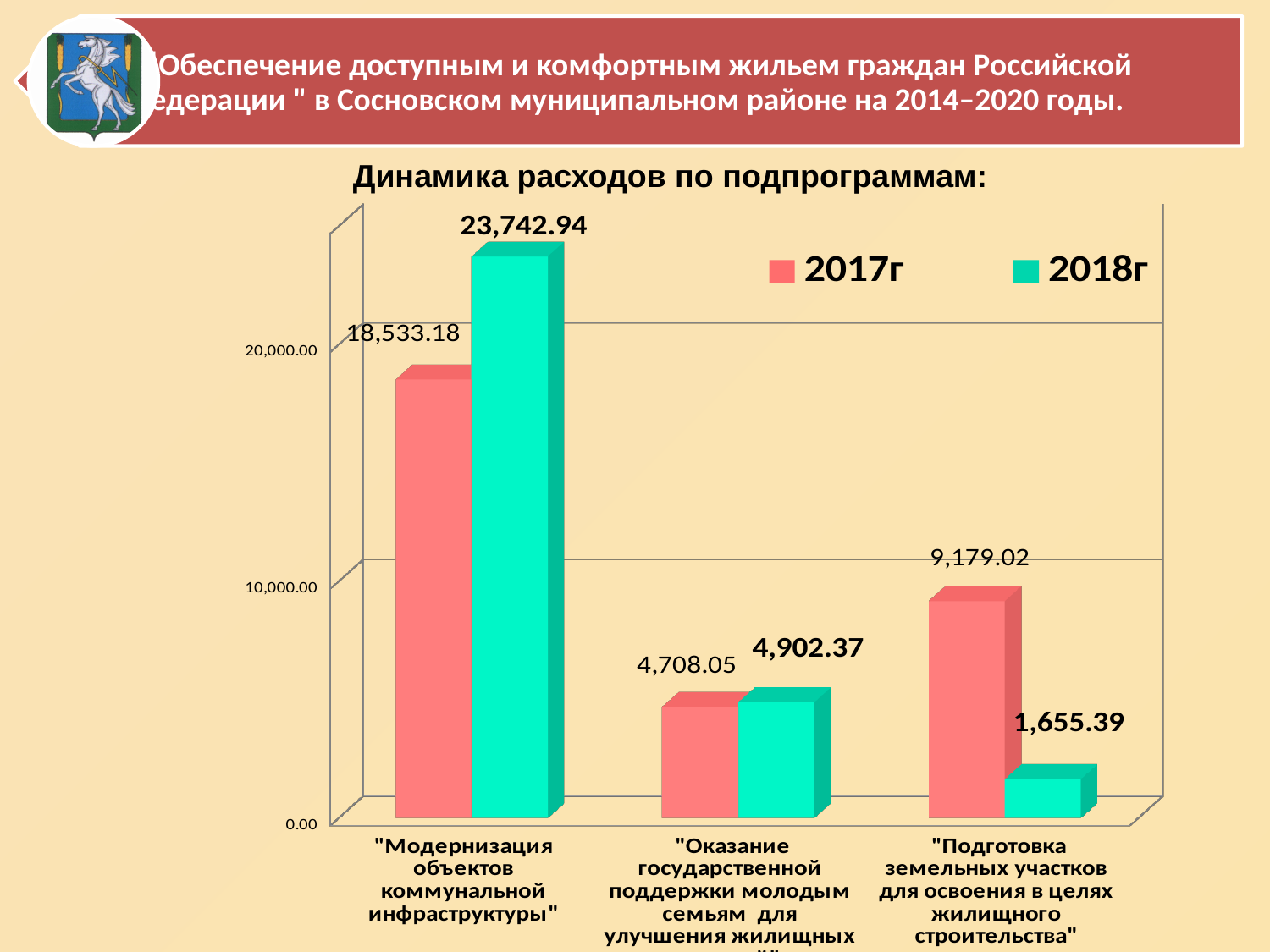
What is the difference between the 2018г and 2017г values for "Модернизация объектов коммунальной инфраструктуры"? 5,209.76 How many categories are shown on the x axis? 3 Which category has the lowest 2017г value? "Оказание государственной поддержки молодым семьям" Which category has the highest 2018г value? "Модернизация объектов коммунальной инфраструктуры" What kind of chart is shown on the slide? bar chart What is the 2017г value for "Оказание государственной поддержки молодым семьям"? 4,708.05 How many series does the legend list? 2 What is the 2017г value for "Модернизация объектов коммунальной инфраструктуры"? 18,533.18 What is the 2018г value for "Модернизация объектов коммунальной инфраструктуры"? 23,742.94 Is the 2017г value for "Подготовка земельных участков для освоения в целях жилищного строительства" greater or less than 10,000.00? less For "Подготовка земельных участков для освоения в целях жилищного строительства", which year has the larger value, 2017г or 2018г? 2017г What is the 2018г value for "Подготовка земельных участков для освоения в целях жилищного строительства"? 1,655.39